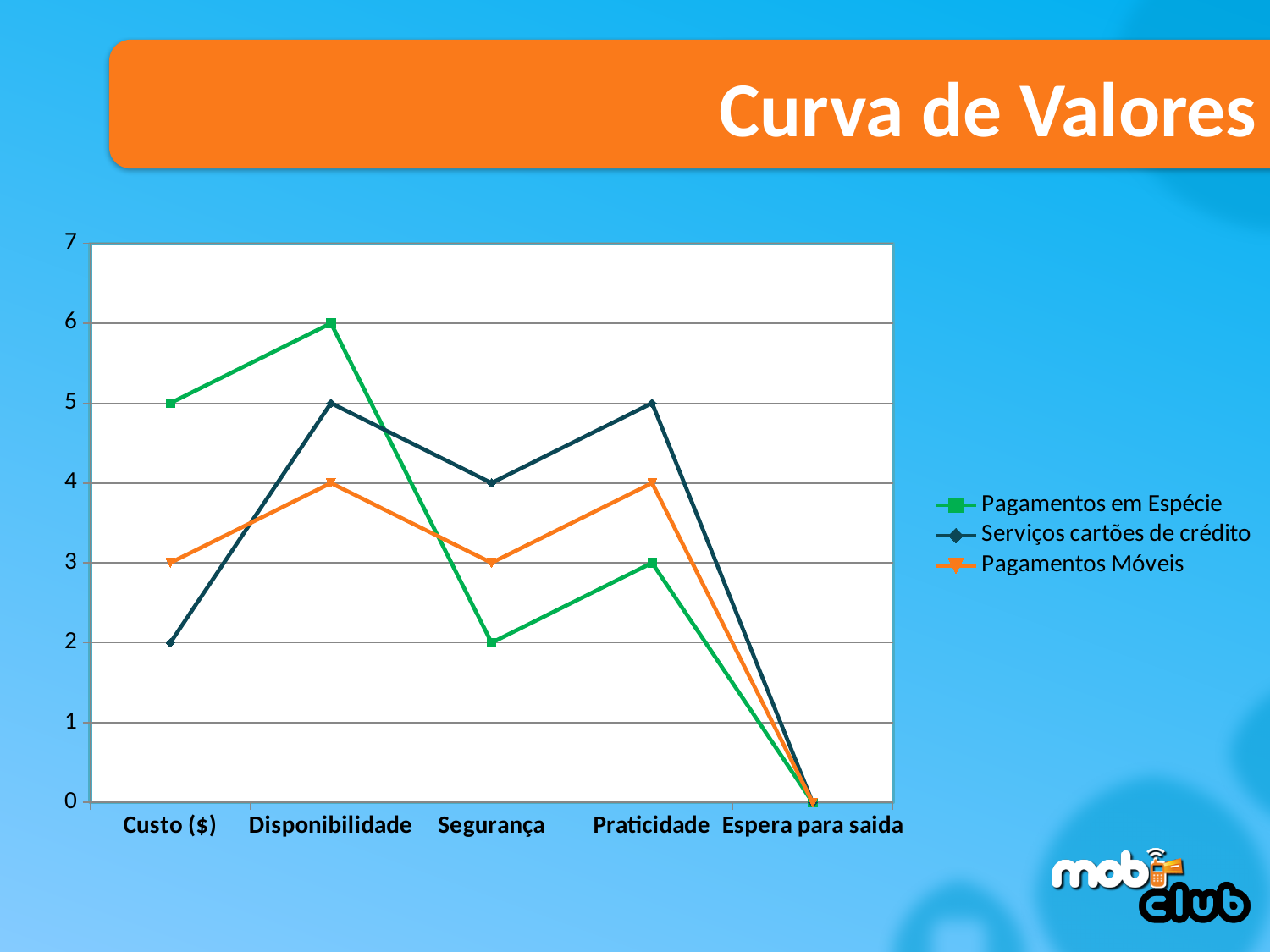
For which category does Pagamentos em Espécie reach its highest value? Disponibilidade What is the value of Pagamentos Móveis for Praticidade? 4 Which series has the higher value for Segurança, Serviços cartões de crédito or Pagamentos em Espécie? Serviços cartões de crédito What is the value of Pagamentos em Espécie for Disponibilidade? 6 What kind of chart is shown on the slide? line chart How many categories are shown on the x axis? 5 Does the Pagamentos em Espécie line rise or fall from Disponibilidade to Segurança? fall What is the title of the slide? Curva de Valores What is the difference between Pagamentos em Espécie and Serviços cartões de crédito for Custo ($)? 3 For which category do all three series have their lowest value? Espera para saida What is the value of Serviços cartões de crédito for Custo ($)? 2 How many series does the legend list? 3